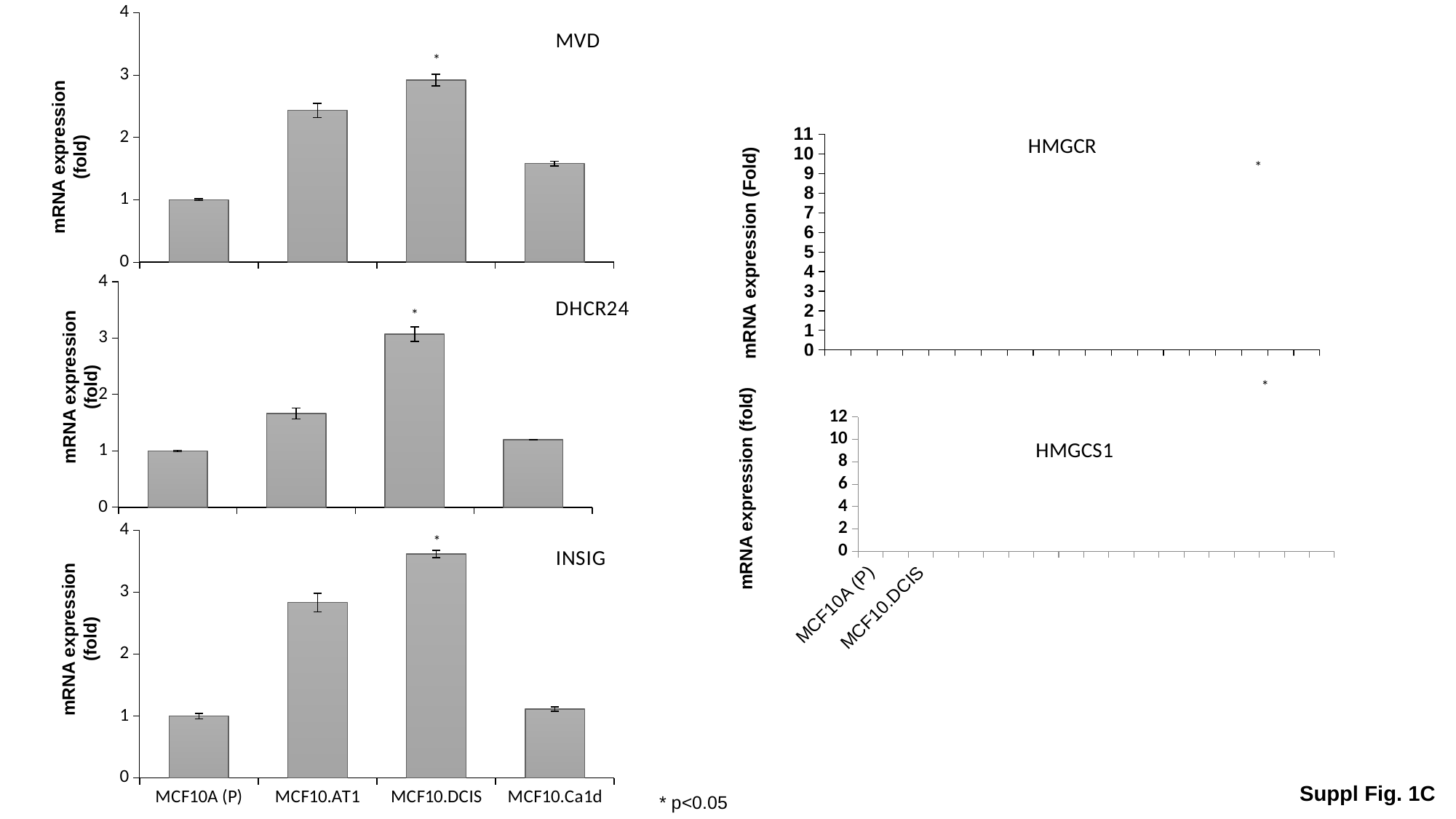
In the DHCR24 chart, is the value for MCF10.AT1 greater or less than 2? less In the MVD chart, which category has the lowest mRNA expression? MCF10A (P) In the DHCR24 chart, which is larger, the value for MCF10.AT1 or MCF10.Ca1d? MCF10.AT1 In the INSIG chart, which category has the highest mRNA expression? MCF10.DCIS In the INSIG chart, is the value for MCF10.DCIS greater or less than 3? greater In the MVD chart, which category has the highest mRNA expression? MCF10.DCIS In the INSIG chart, which is larger, the value for MCF10.AT1 or MCF10.Ca1d? MCF10.AT1 In the DHCR24 chart, which category has the highest mRNA expression? MCF10.DCIS In the MVD chart, is the value for MCF10.AT1 greater or less than 2? greater How many categories are shown on the x axis of the INSIG chart? 4 What kind of chart is the MVD chart? bar chart